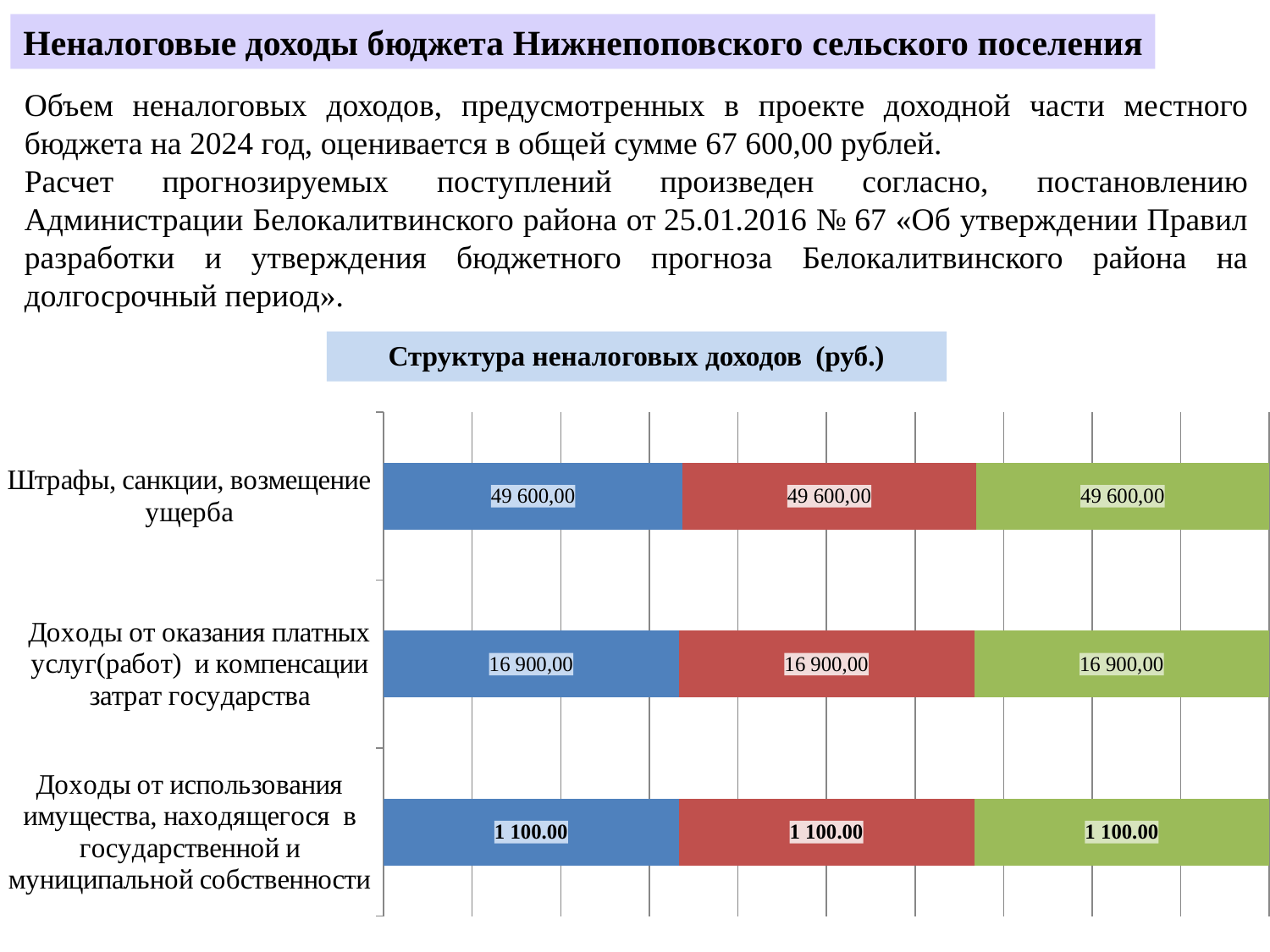
What is the value labelled on the blue segment for «Штрафы, санкции, возмещение ущерба»? 49 600,00 How many coloured segments does each bar in the chart consist of? 3 What is the value labelled on the blue segment for «Доходы от оказания платных услуг(работ) и компенсации затрат государства»? 16 900,00 What is the difference between the labelled value for «Штрафы, санкции, возмещение ущерба» and the labelled value for «Доходы от оказания платных услуг(работ) и компенсации затрат государства»? 32 700,00 What is the title of the chart? Структура неналоговых доходов (руб.) What is the value labelled on the blue segment for «Доходы от использования имущества, находящегося в государственной и муниципальной собственности»? 1 100.00 Which category has the lowest labelled value? Доходы от использования имущества, находящегося в государственной и муниципальной собственности Which category has the highest labelled value? Штрафы, санкции, возмещение ущерба What is the total of the three labelled segments in the bar for «Штрафы, санкции, возмещение ущерба»? 148 800,00 Which is larger: the labelled value for «Доходы от оказания платных услуг(работ) и компенсации затрат государства» or for «Доходы от использования имущества, находящегося в государственной и муниципальной собственности»? Доходы от оказания платных услуг(работ) и компенсации затрат государства What type of chart is shown under the title «Структура неналоговых доходов (руб.)»? bar chart How many categories are shown on the chart? 3